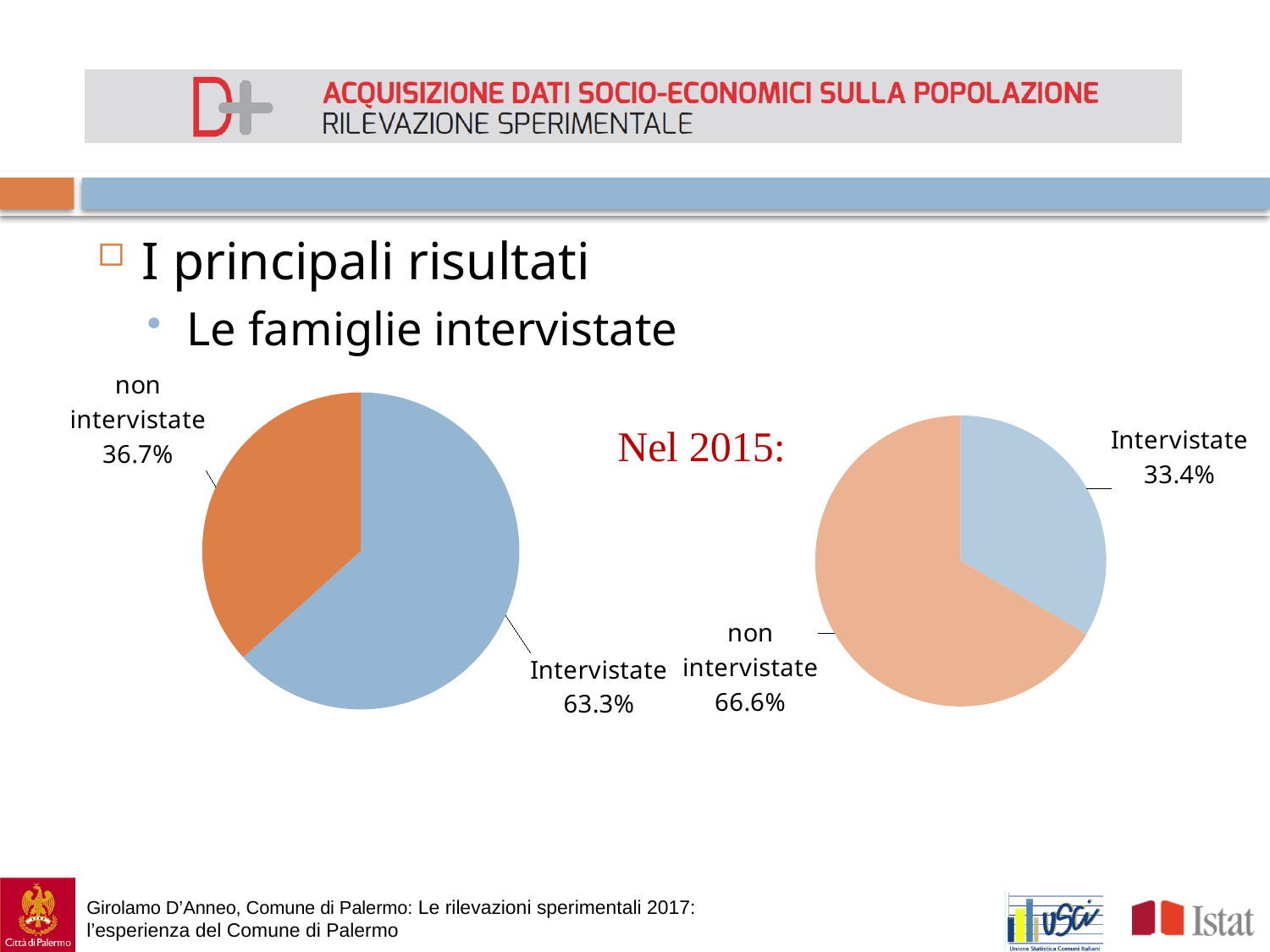
In the right pie chart (Nel 2015), what share is labelled for non intervistate? 66.6% In the right pie chart (Nel 2015), what is the difference in percentage points between non intervistate and Intervistate? 33.2 In the left pie chart, what share is labelled for non intervistate? 36.7% In the left pie chart, what share is labelled for Intervistate? 63.3% In the left pie chart, which slice is the largest? Intervistate Is the Intervistate share larger in the left pie chart or in the right pie chart (Nel 2015)? left pie chart In the left pie chart, what is the difference in percentage points between Intervistate and non intervistate? 26.6 How many slices does the left pie chart have? 2 How many pie charts are shown on the slide? 2 In the right pie chart (Nel 2015), what share is labelled for Intervistate? 33.4% What type of chart is the right chart labelled Nel 2015? pie chart In the right pie chart (Nel 2015), which slice is the smallest? Intervistate